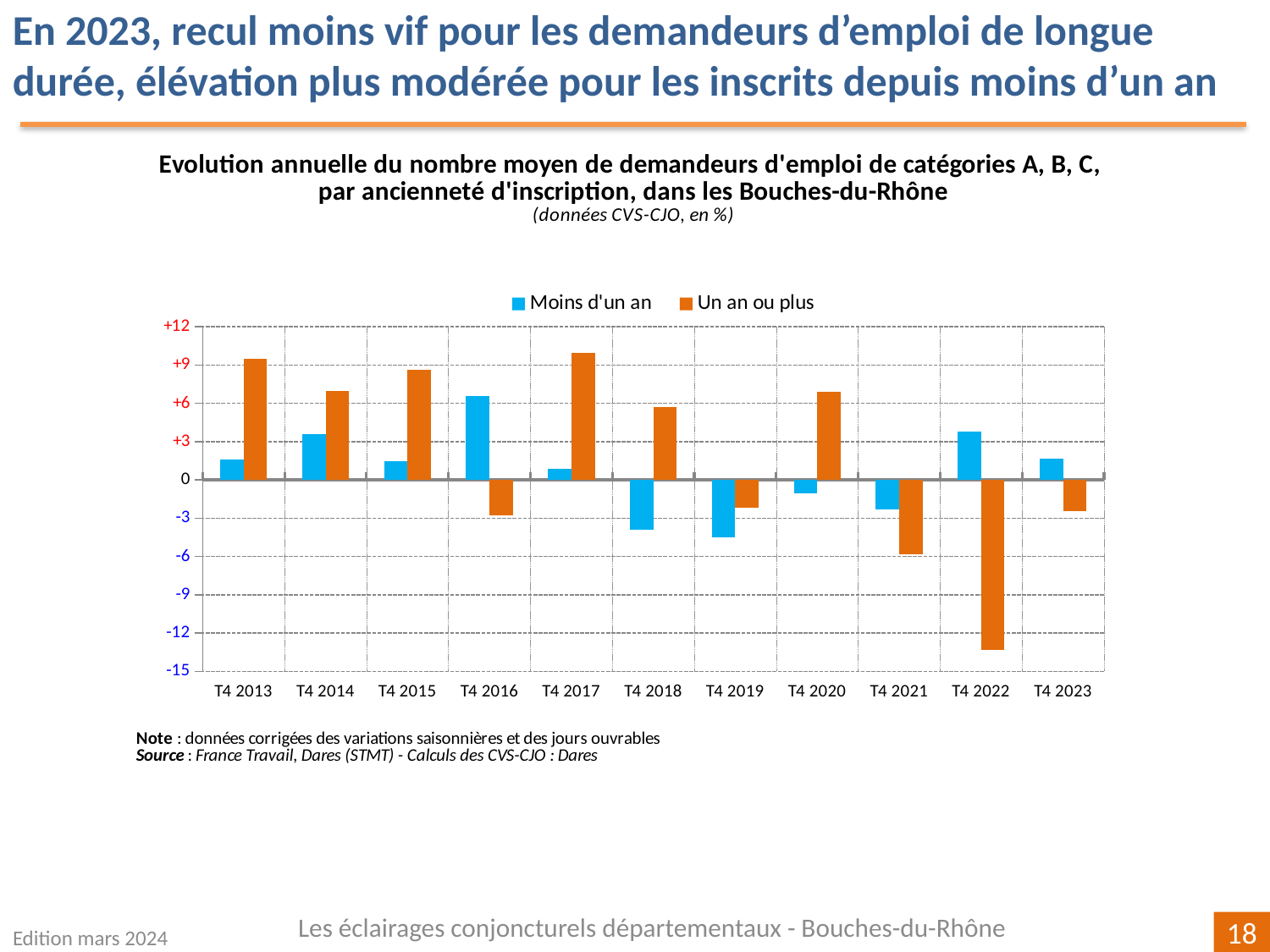
How many time periods (categories) are shown on the x axis? 11 Is the value for 'Moins d'un an' in T4 2016 greater or less than 6? greater In which period is the value for 'Moins d'un an' the highest? T4 2016 Is the value for 'Un an ou plus' in T4 2022 greater or less than -12? less Is the value for 'Un an ou plus' in T4 2013 greater or less than 9? greater In T4 2020, which series has the larger value, 'Moins d'un an' or 'Un an ou plus'? Un an ou plus What kind of chart is shown on the slide? bar chart How many series does the legend list? 2 In T4 2022, which series has the larger value, 'Moins d'un an' or 'Un an ou plus'? Moins d'un an Which colour represents the 'Un an ou plus' series? orange In which period is the value for 'Un an ou plus' the lowest? T4 2022